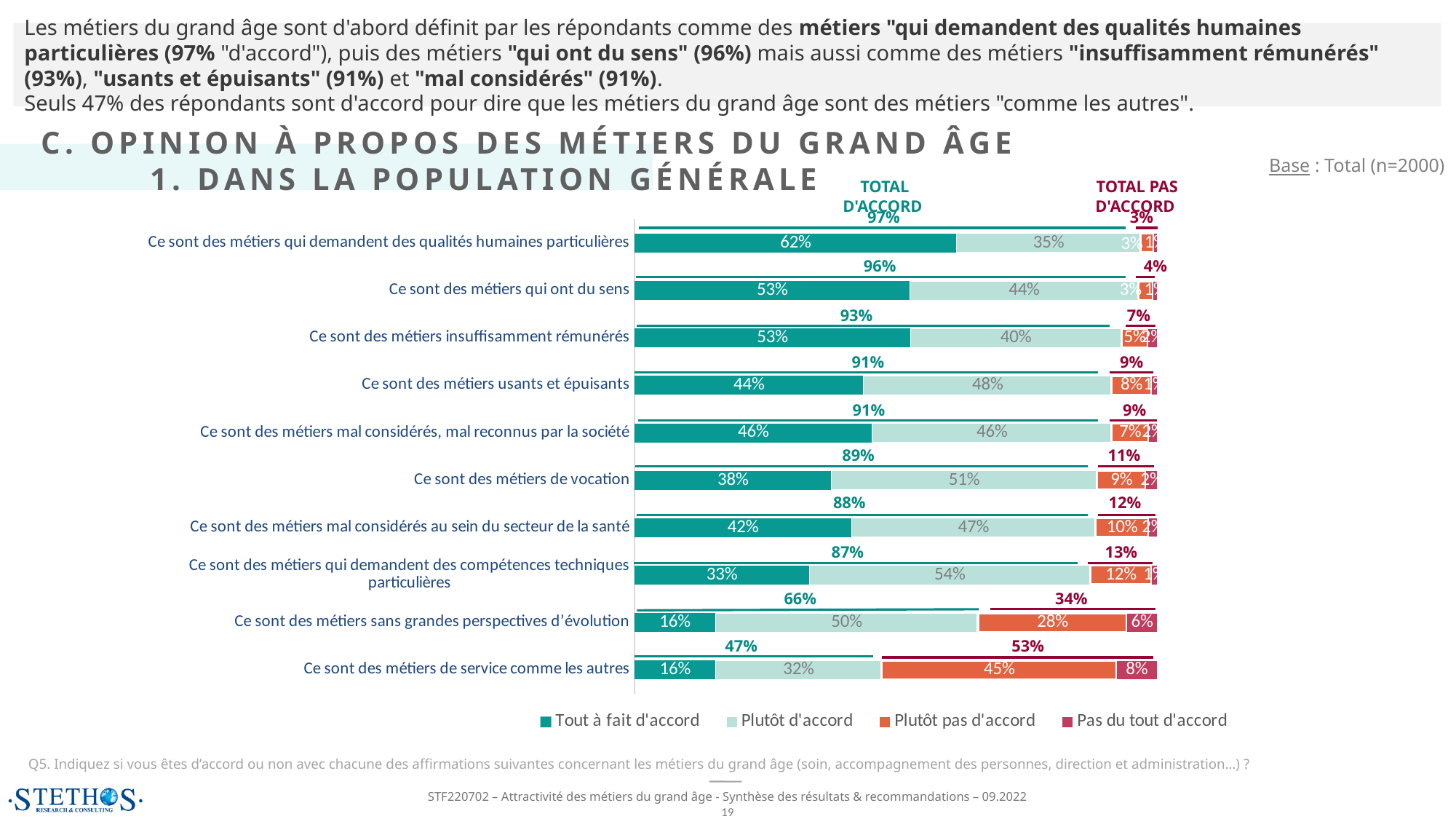
How many series does the legend list? 4 How many statements (categories) are plotted in the chart? 10 Which legend entry is shown in orange? Plutôt pas d'accord What is the "Plutôt pas d'accord" value for "Ce sont des métiers de service comme les autres"? 45% Which is larger: the "Plutôt pas d'accord" value for "Ce sont des métiers sans grandes perspectives d'évolution" or for "Ce sont des métiers de vocation"? Ce sont des métiers sans grandes perspectives d'évolution What is the "Tout à fait d'accord" value for "Ce sont des métiers qui demandent des qualités humaines particulières"? 62% What kind of chart is shown on the slide? Stacked bar chart What is the TOTAL PAS D'ACCORD value for "Ce sont des métiers mal considérés au sein du secteur de la santé"? 12% Which statement has the lowest TOTAL D'ACCORD value? Ce sont des métiers de service comme les autres Which statement has the highest "Tout à fait d'accord" value? Ce sont des métiers qui demandent des qualités humaines particulières What is the difference between the TOTAL D'ACCORD values for "Ce sont des métiers sans grandes perspectives d'évolution" and "Ce sont des métiers de service comme les autres"? 19% What is the "Plutôt d'accord" value for "Ce sont des métiers qui demandent des compétences techniques particulières"? 54%